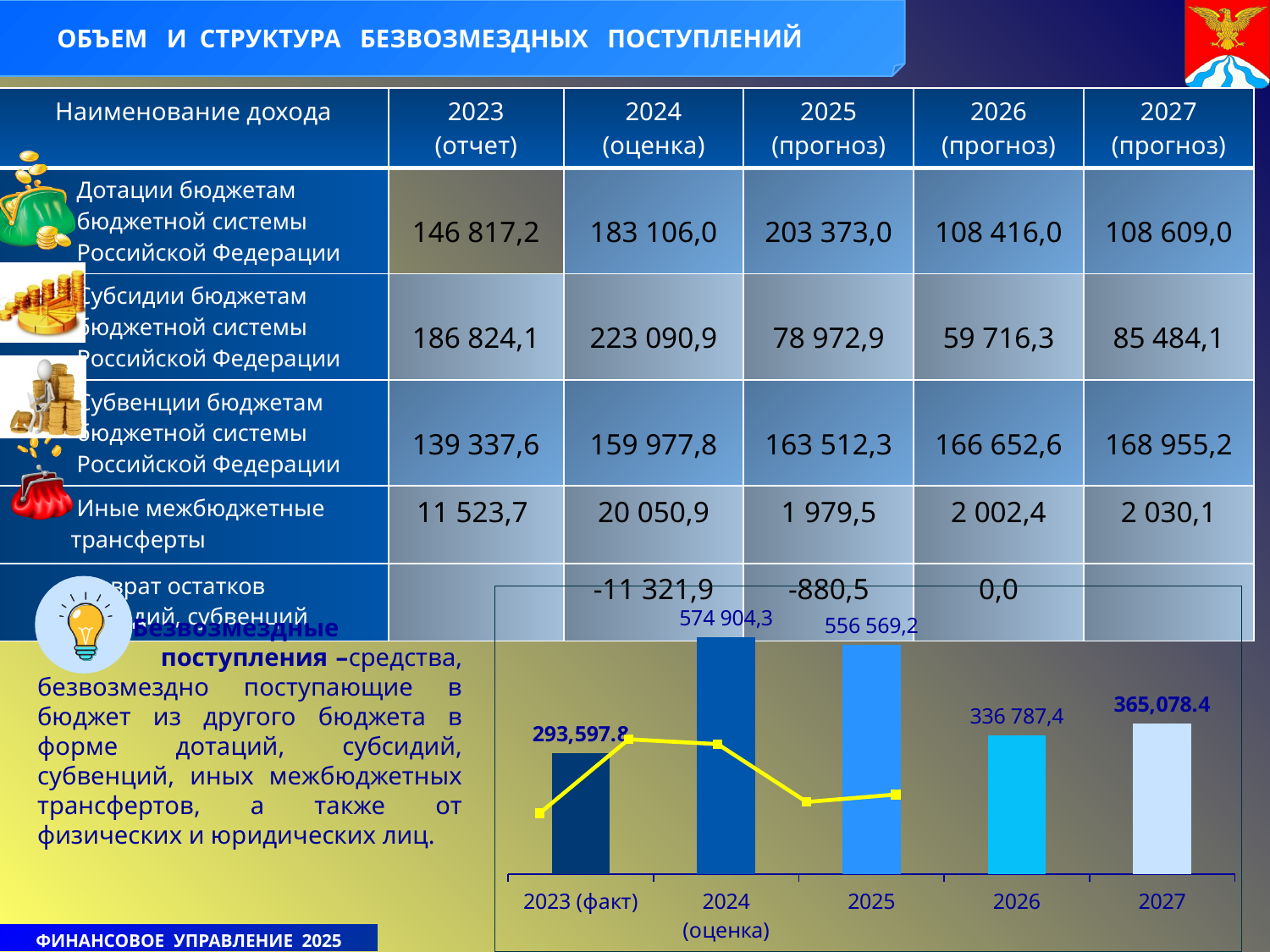
How many bars (categories) are shown in the chart at the bottom of the slide? 5 In the bar chart at the bottom of the slide, which year has the lowest bar? 2023 (факт) In the bar chart at the bottom of the slide, what is the value shown for 2024 (оценка)? 574 904,3 In the bar chart at the bottom of the slide, which is larger: the value for 2027 or the value for 2023 (факт)? 2027 What kind of chart is shown at the bottom of the slide? bar chart In the bar chart at the bottom of the slide, what is the value shown for 2023 (факт)? 293,597.8 In the bar chart at the bottom of the slide, what is the value shown for 2025? 556 569,2 In the bar chart at the bottom of the slide, what is the value shown for 2026? 336 787,4 In the bar chart at the bottom of the slide, which year has the highest bar? 2024 (оценка) In the bar chart at the bottom of the slide, what is the difference between the values for 2024 (оценка) and 2025? 18 335,1 In the bar chart at the bottom of the slide, do the bar values rise or fall from 2024 (оценка) to 2026? fall In the bar chart at the bottom of the slide, which is larger: the value for 2025 or the value for 2026? 2025